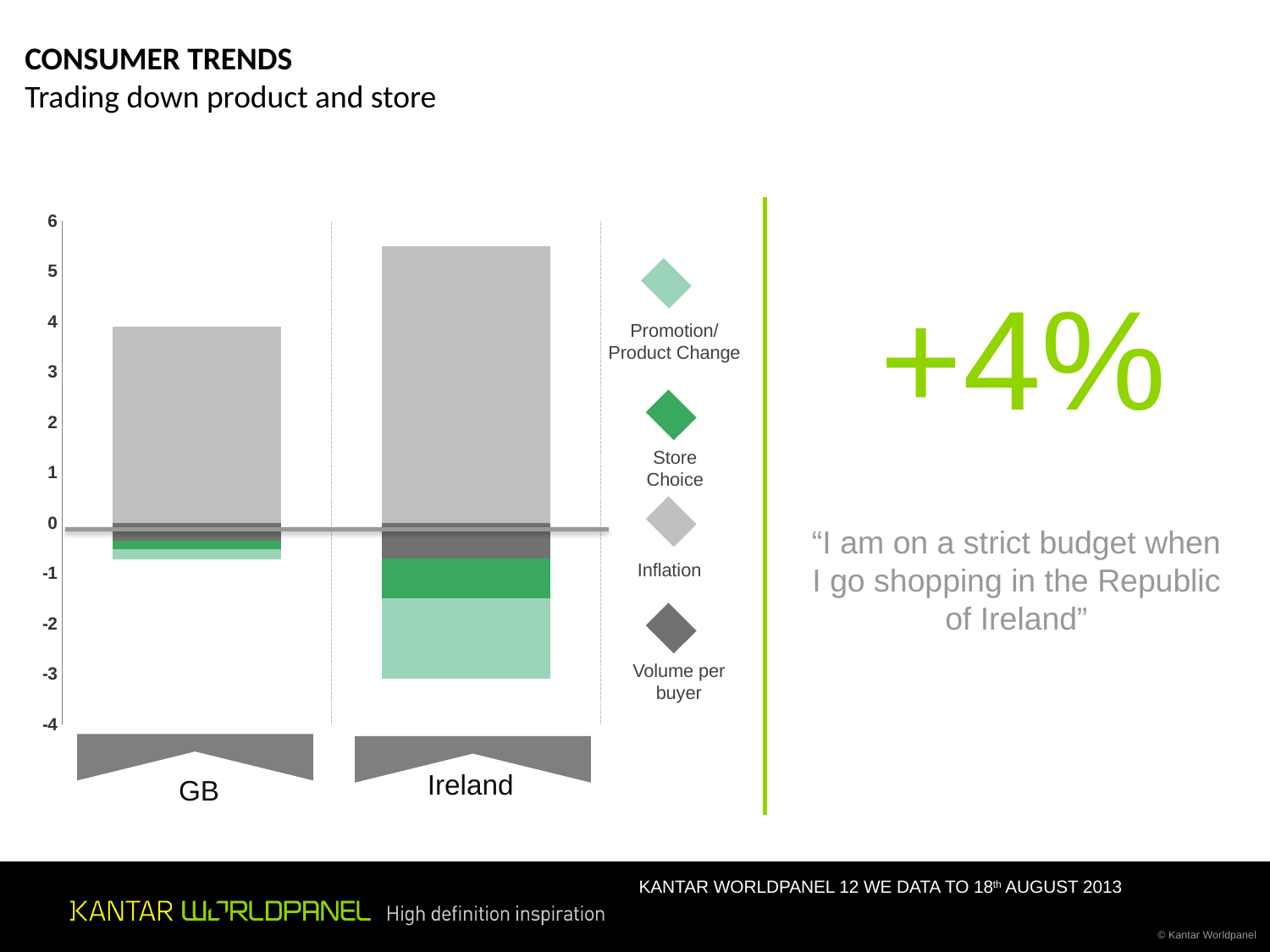
Which category has the larger negative Promotion/Product Change segment, GB or Ireland? Ireland What kind of chart is shown on the slide? stacked bar chart Is the Inflation value for Ireland greater or less than 5? greater What is the highest value shown on the chart's y axis? 6 Which category has the taller positive bar, GB or Ireland? Ireland Which category has the larger Inflation value, GB or Ireland? Ireland Is the Inflation value for GB greater or less than 3? greater Which legend entry is shown in dark green? Store Choice How many categories are shown on the x axis of the chart? 2 Which category has the larger negative Store Choice segment, GB or Ireland? Ireland Is the Inflation value for GB greater or less than 5? less How many series does the chart legend list? 4